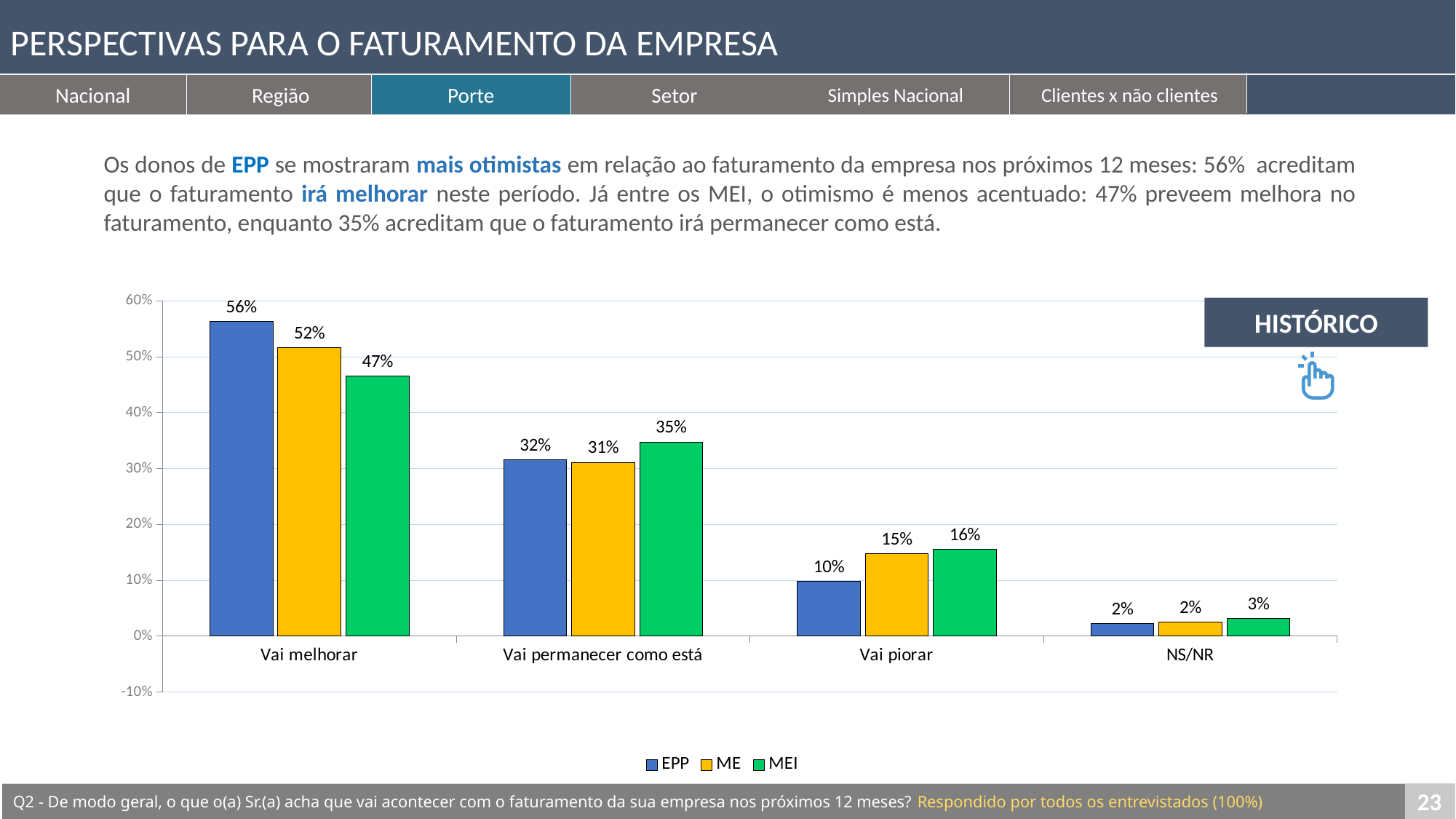
What kind of chart is shown on the slide? Bar chart What is the value for ME in the 'Vai piorar' category? 15% Which is larger: the ME value for 'Vai permanecer como está' or the MEI value for 'Vai permanecer como está'? MEI What is the difference between the EPP and MEI values in the 'Vai melhorar' category? 9% Which series has the highest value in the 'Vai melhorar' category? EPP How many series does the legend list? 3 What is the value for MEI in the 'NS/NR' category? 3% Which colour represents the ME series in the chart? Yellow What is the value for EPP in the 'Vai melhorar' category? 56% What is the value for MEI in the 'Vai permanecer como está' category? 35% Which series has the lowest value in the 'Vai piorar' category? EPP How many categories are shown on the x axis? 4